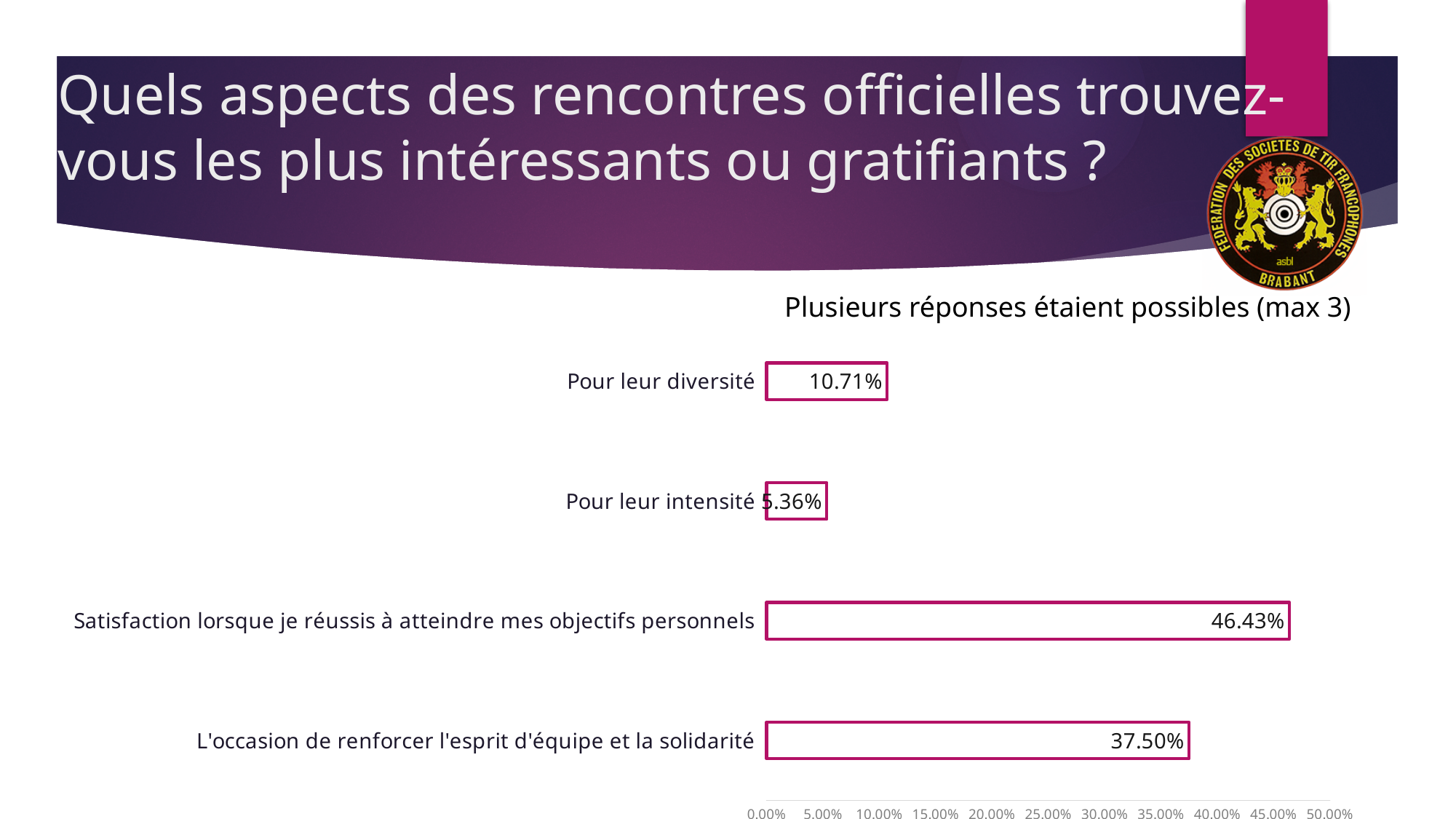
What is the value for "Pour leur diversité"? 10.71% Is the value for "L'occasion de renforcer l'esprit d'équipe et la solidarité" greater or less than 40.00%? less What is the highest value shown on the x axis? 50.00% What is the value for "L'occasion de renforcer l'esprit d'équipe et la solidarité"? 37.50% What is the value for "Satisfaction lorsque je réussis à atteindre mes objectifs personnels"? 46.43% Which category has the lowest value? Pour leur intensité Which category has the highest value? Satisfaction lorsque je réussis à atteindre mes objectifs personnels How many categories are shown in the chart? 4 What kind of chart is shown on the slide? bar chart What is the difference between the values for "Satisfaction lorsque je réussis à atteindre mes objectifs personnels" and "L'occasion de renforcer l'esprit d'équipe et la solidarité"? 8.93% What is the value for "Pour leur intensité"? 5.36% Which is larger: the value for "Pour leur diversité" or the value for "Pour leur intensité"? Pour leur diversité